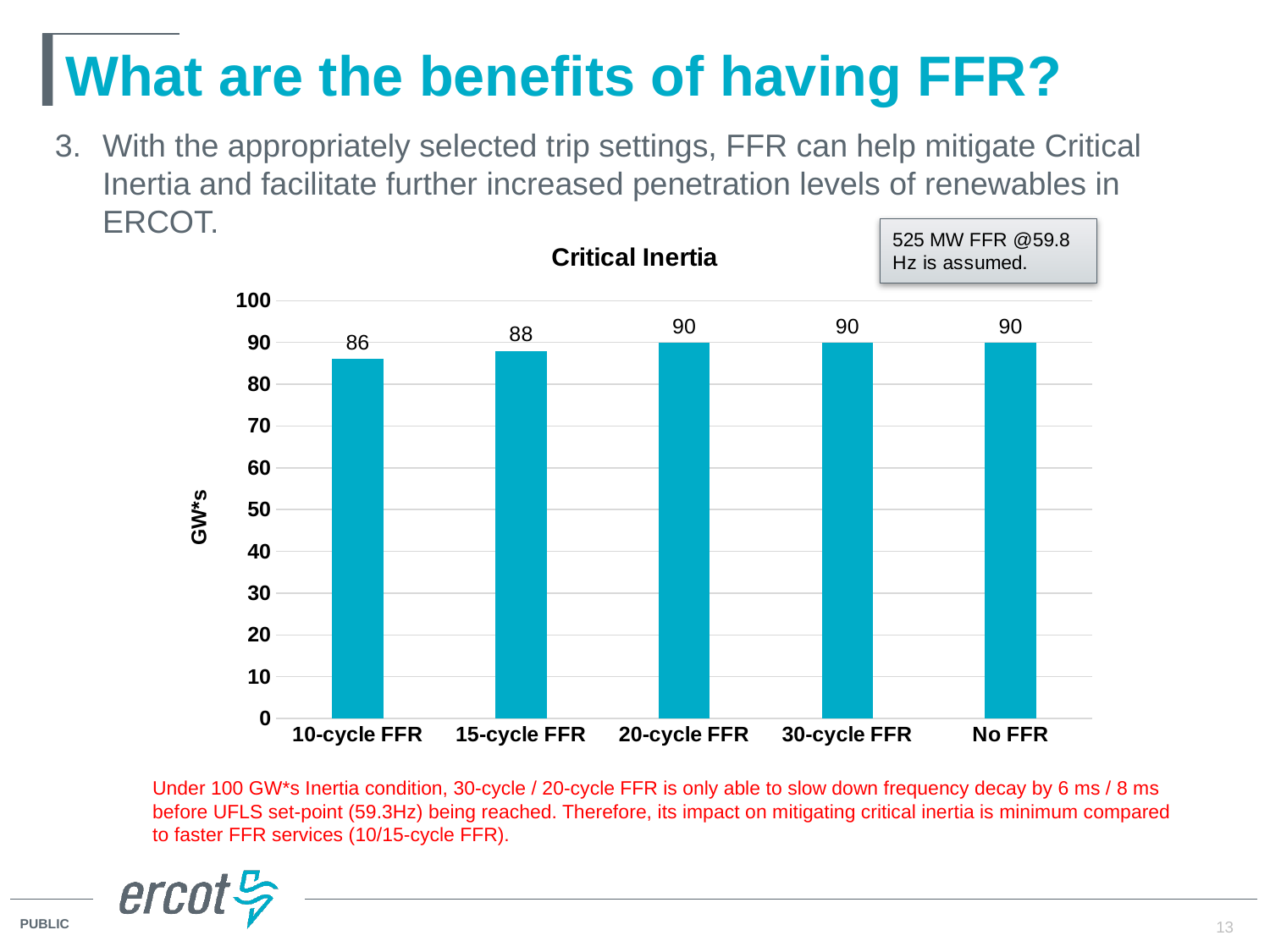
What is the Critical Inertia value for 10-cycle FFR? 86 What is the title of the chart? Critical Inertia What is the Critical Inertia value for No FFR? 90 Which is larger, the Critical Inertia value for 15-cycle FFR or for 20-cycle FFR? 20-cycle FFR What kind of chart is shown on the slide? bar chart What is the difference between the Critical Inertia values for No FFR and 10-cycle FFR? 4 Is the value for 10-cycle FFR greater or less than 90? less What is the label on the y axis of the chart? GW*s How many categories are shown on the x axis of the chart? 5 Which category has the lowest Critical Inertia value? 10-cycle FFR What is the Critical Inertia value for 15-cycle FFR? 88 What is the difference between the Critical Inertia values for 15-cycle FFR and 10-cycle FFR? 2